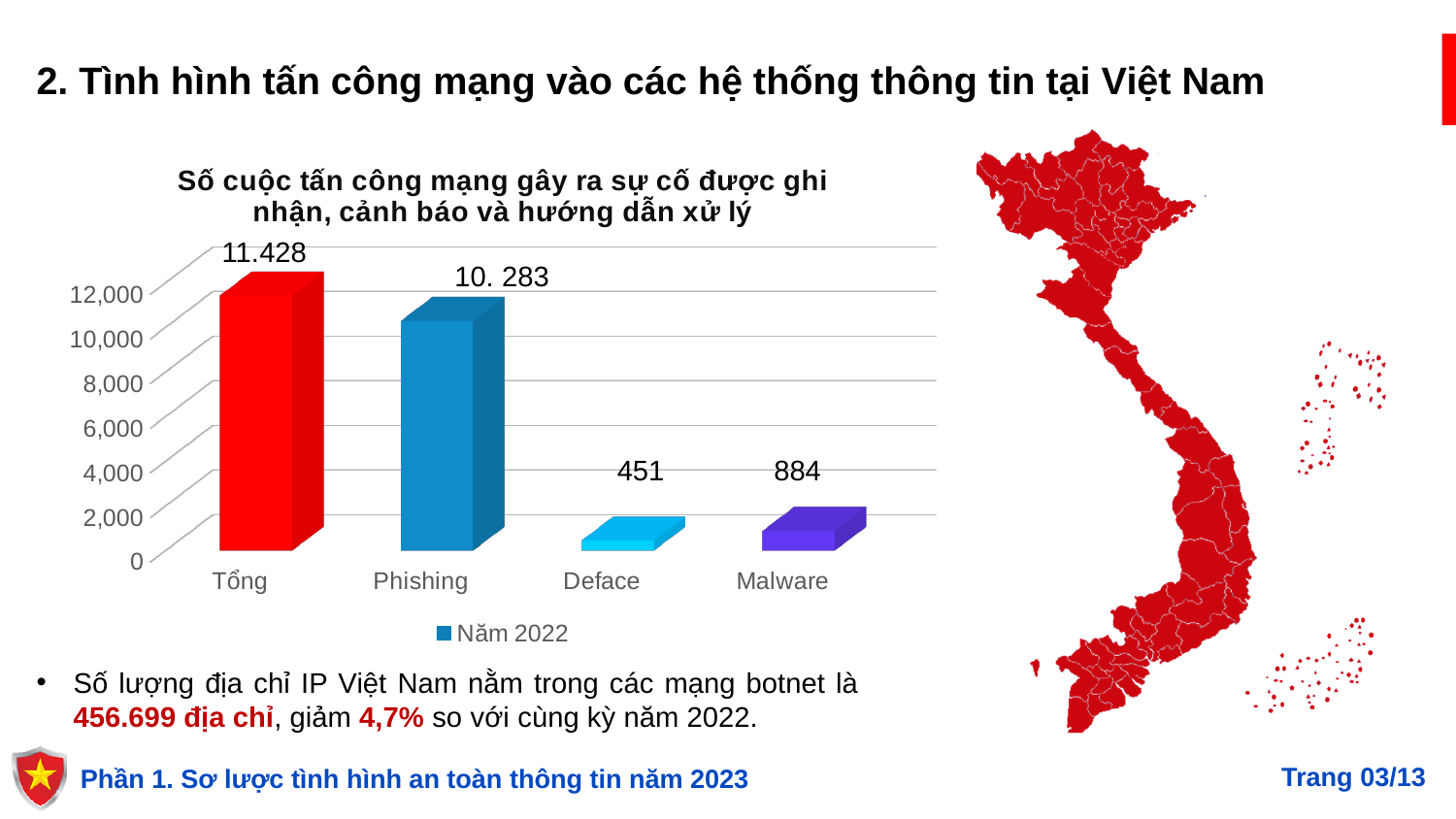
What is the value for Tổng in the chart? 11.428 What is the difference between the values for Malware and Deface? 433 Which category has the highest value in the chart? Tổng Which is larger, the value for Phishing or the value for Malware? Phishing What is the value for Deface in the chart? 451 What series does the chart legend list? Năm 2022 What is the value for Phishing in the chart? 10. 283 How many categories are shown on the x axis of the chart? 4 What type of chart is shown on the slide? bar chart Is the value for Deface greater or less than 2,000? less What is the value for Malware in the chart? 884 Which category has the lowest value in the chart? Deface